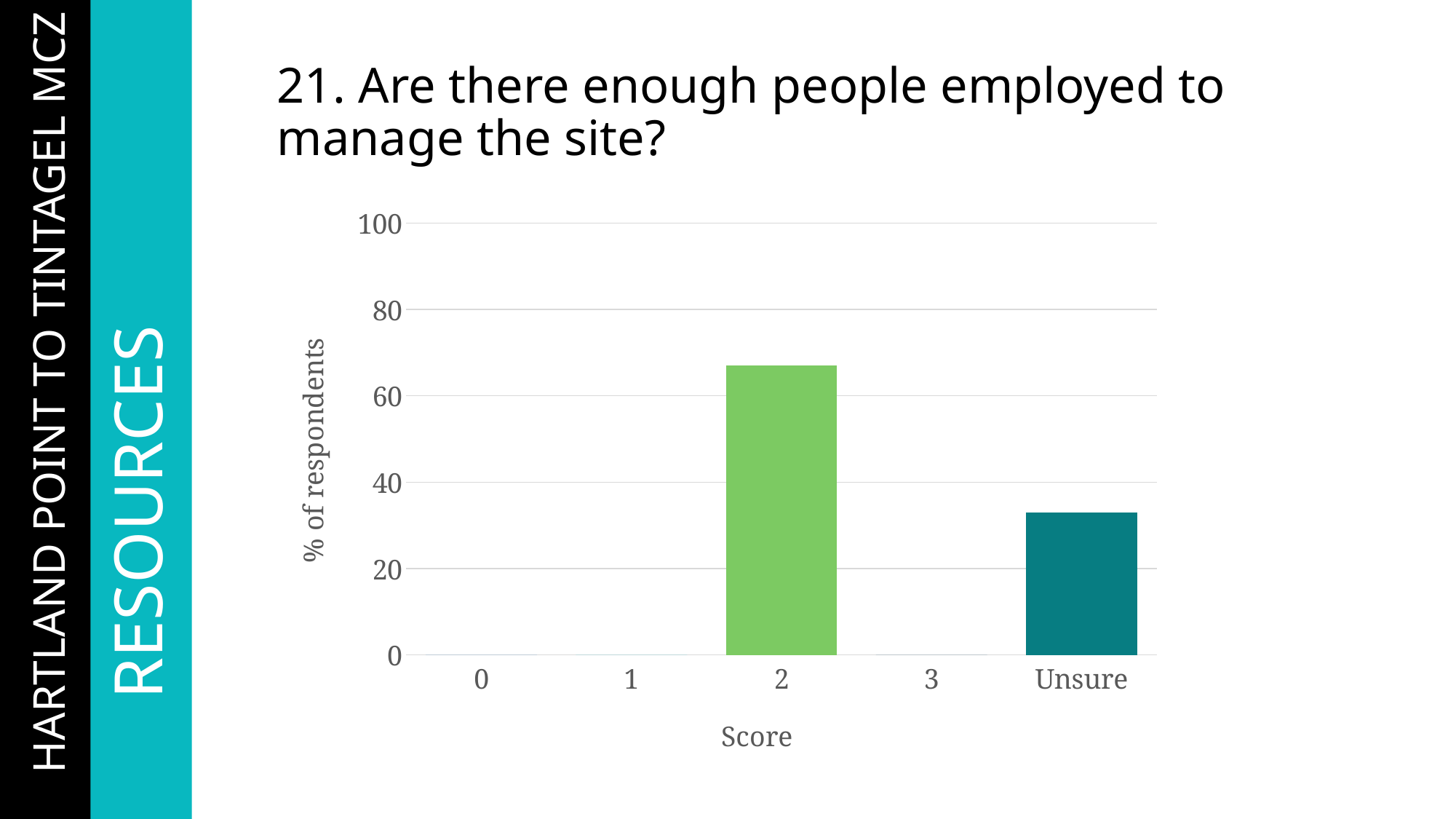
Is the value for score 2 greater or less than 60? greater Which score category has the highest percentage of respondents? 2 Which is larger, the value for score 2 or the value for Unsure? score 2 What is the label of the y axis of the chart? % of respondents What kind of chart is shown on the slide? bar chart What is the label of the x axis of the chart? Score Is the value for score 2 greater or less than 80? less How many categories are shown on the x axis of the chart? 5 Which is larger, the value for Unsure or the value for score 3? Unsure Is the value for Unsure greater or less than 40? less